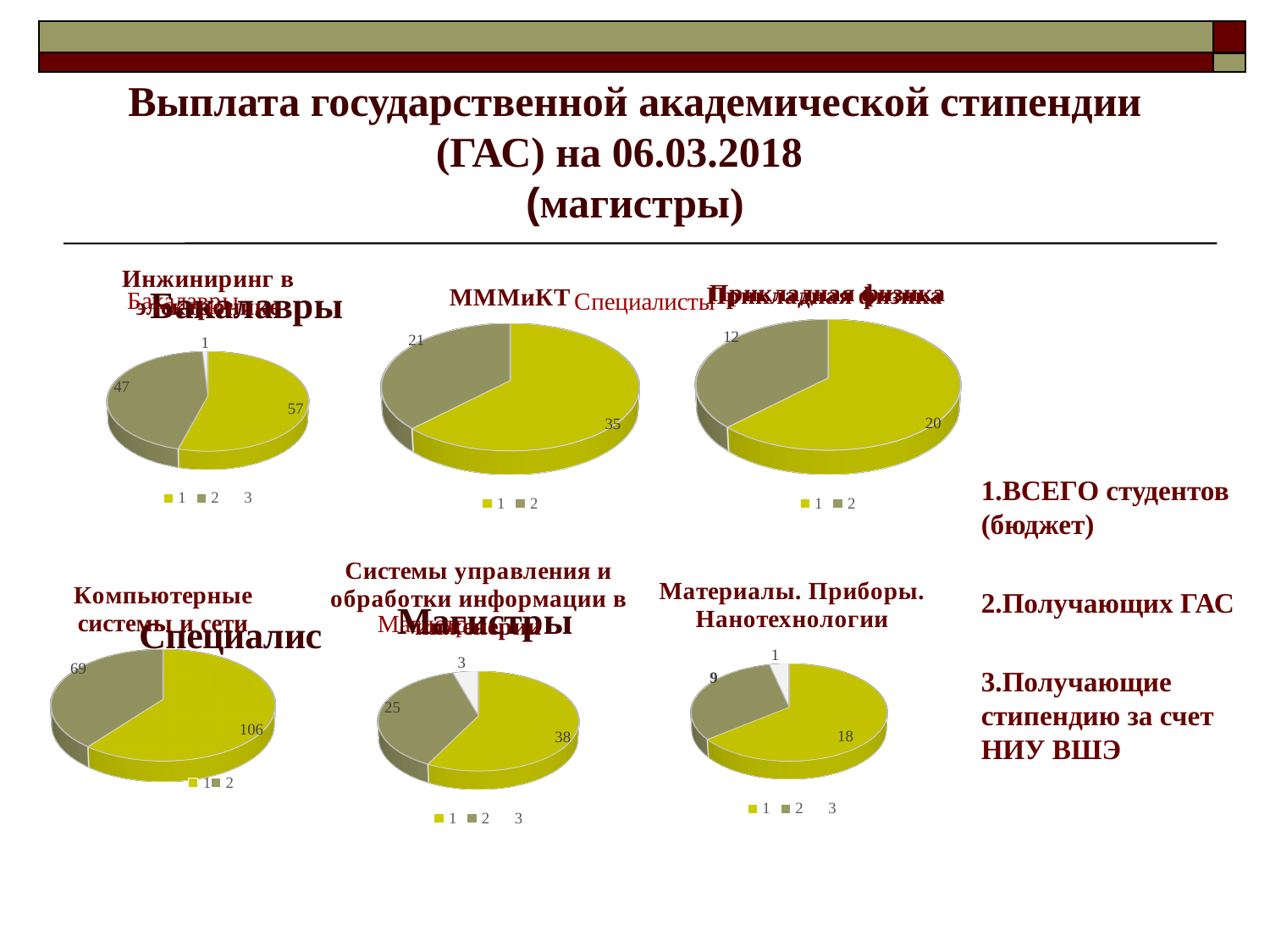
In the bottom-middle pie chart, what is the total of all slices (38, 25 and 3)? 66 In the bottom-right pie chart (Материалы. Приборы. Нанотехнологии), what is the value for category 2? 9 In the top-left pie chart, which is larger: the slice for category 1 (57) or category 2 (47)? 1 In the bottom-left pie chart (Компьютерные системы и сети), which category has the largest slice? 1 In the top-middle pie chart (МММиКТ), what is the value for category 1? 35 How many slices does the top-left pie chart have? 3 What type of chart is used for the top-middle chart (МММиКТ)? Pie chart In the top-right pie chart, what is the difference between the values 20 and 12? 8 In the top-right pie chart, what share of the total does the slice with value 20 represent? 62.5% In the bottom-middle pie chart, what is the value for category 3? 3 How many pie charts are shown on the slide? 6 How many entries does the legend of the bottom-right pie chart list? 3